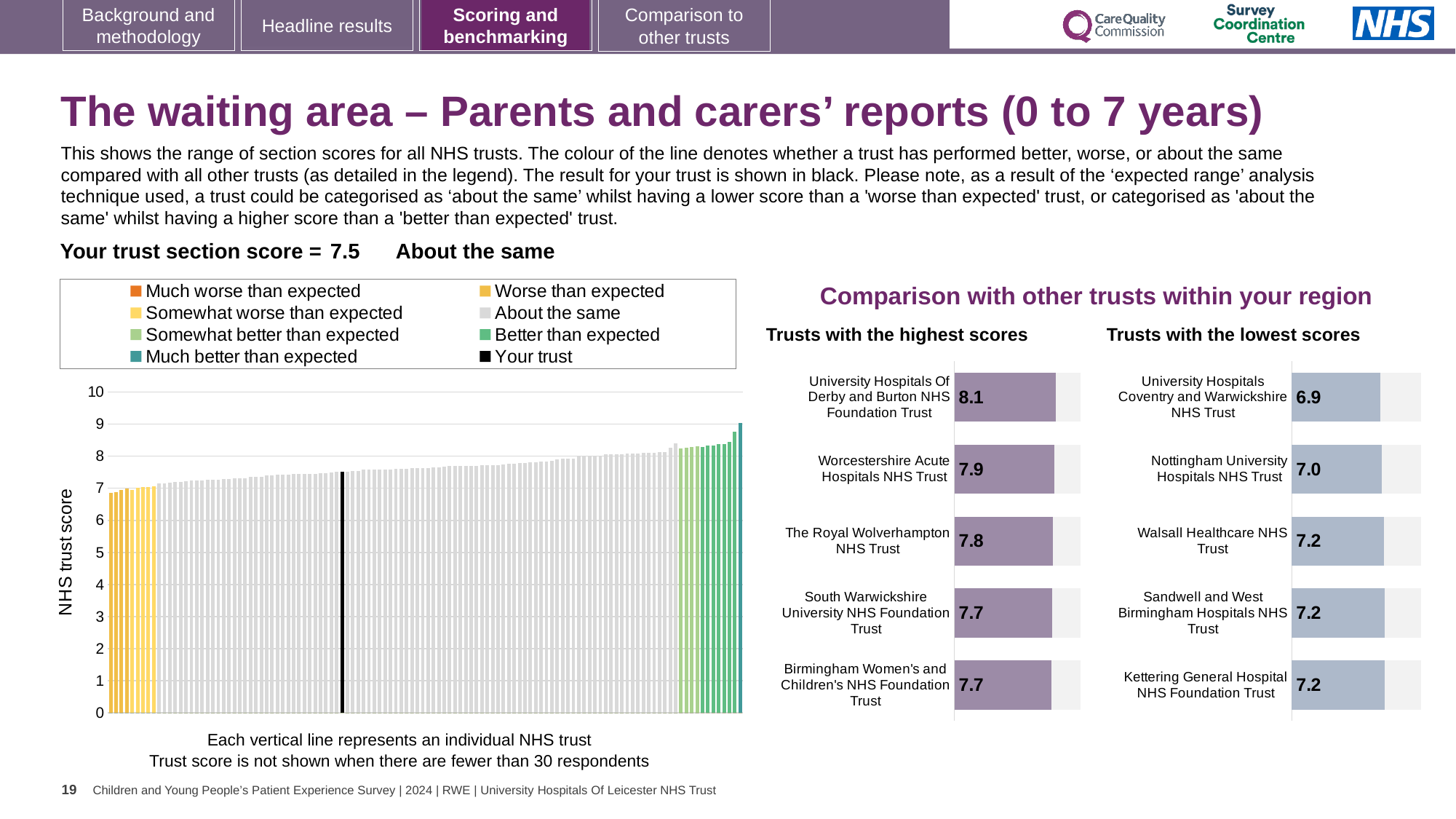
How many entries does the legend of the large chart on the left list? 8 What kind of chart is the large chart on the left showing all NHS trusts? Bar chart In the 'Trusts with the lowest scores' chart, what is the score for Nottingham University Hospitals NHS Trust? 7.0 In the 'Trusts with the highest scores' chart, what is the score for University Hospitals Of Derby and Burton NHS Foundation Trust? 8.1 In the 'Trusts with the highest scores' chart, what is the difference between the scores of University Hospitals Of Derby and Burton NHS Foundation Trust and Worcestershire Acute Hospitals NHS Trust? 0.2 In the 'Trusts with the lowest scores' chart, which trust has the lowest score? University Hospitals Coventry and Warwickshire NHS Trust In the 'Trusts with the highest scores' chart, which trust has the highest score? University Hospitals Of Derby and Burton NHS Foundation Trust In the large chart on the left, is the value for the black bar (your trust) greater or less than 7? greater In the 'Trusts with the lowest scores' chart, what is the score for University Hospitals Coventry and Warwickshire NHS Trust? 6.9 Which has a higher score: The Royal Wolverhampton NHS Trust in the highest scores chart or Nottingham University Hospitals NHS Trust in the lowest scores chart? The Royal Wolverhampton NHS Trust In the 'Trusts with the lowest scores' chart, what is the difference between the scores of Walsall Healthcare NHS Trust and University Hospitals Coventry and Warwickshire NHS Trust? 0.3 How many trusts are shown in the 'Trusts with the highest scores' chart? 5